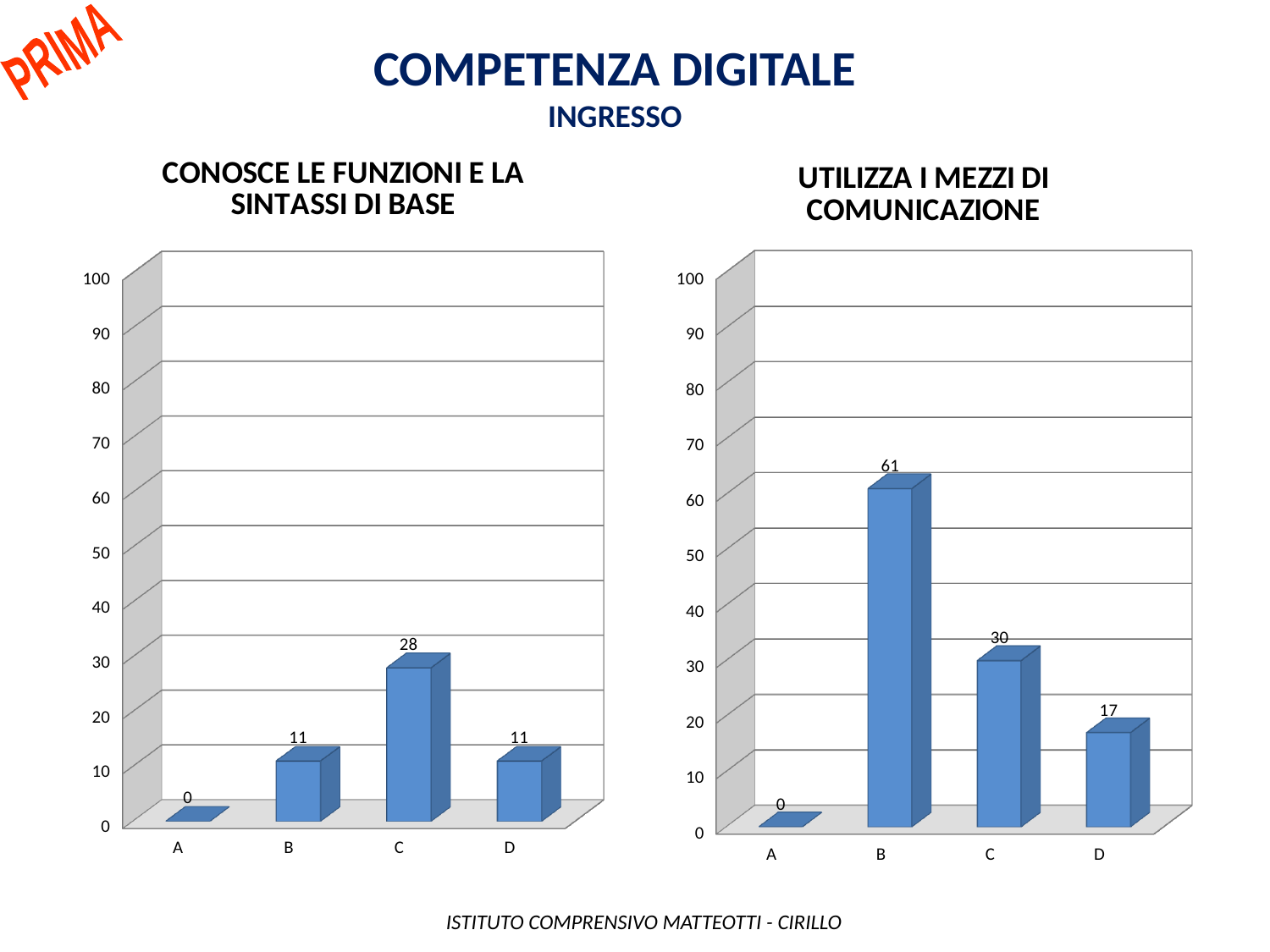
In the 'UTILIZZA I MEZZI DI COMUNICAZIONE' chart, what is the difference between the values for B and C? 31 What kind of chart is the 'UTILIZZA I MEZZI DI COMUNICAZIONE' chart? Bar chart In the 'CONOSCE LE FUNZIONI E LA SINTASSI DI BASE' chart, what is the difference between the values for C and B? 17 In the 'UTILIZZA I MEZZI DI COMUNICAZIONE' chart, is the value for B greater or less than 50? greater In the 'CONOSCE LE FUNZIONI E LA SINTASSI DI BASE' chart, which category has the highest value? C What is the main title at the top of the slide? COMPETENZA DIGITALE In the 'UTILIZZA I MEZZI DI COMUNICAZIONE' chart, what is the value for B? 61 In the 'UTILIZZA I MEZZI DI COMUNICAZIONE' chart, what is the value for D? 17 How many categories are shown in the 'CONOSCE LE FUNZIONI E LA SINTASSI DI BASE' chart? 4 In the 'UTILIZZA I MEZZI DI COMUNICAZIONE' chart, which category has the lowest value? A In the 'UTILIZZA I MEZZI DI COMUNICAZIONE' chart, which is larger, the value for C or the value for D? C In the 'CONOSCE LE FUNZIONI E LA SINTASSI DI BASE' chart, what is the value for C? 28